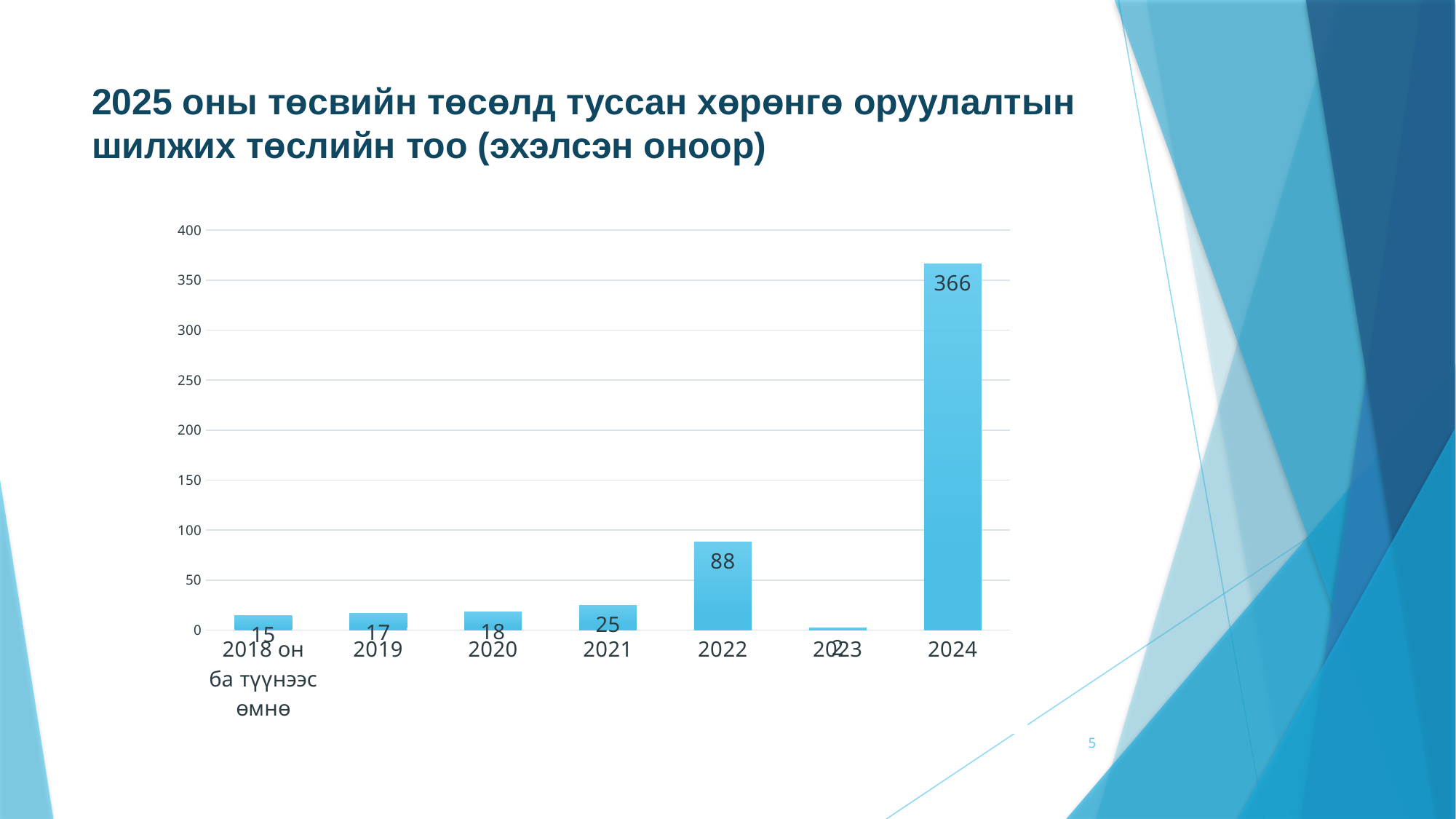
What is the value for 2024? 366 Which year has the lowest value? 2023 What is the value for 2022? 88 Which is larger, the value for 2021 or the value for 2020? 2021 What is the difference between the values for 2020 and 2019? 1 What is the value for 2021? 25 Which year has the highest value? 2024 What kind of chart is shown on the slide? bar chart How many categories are shown on the x axis? 7 What is the value for 2019? 17 Is the value for 2024 greater or less than 350? greater What is the difference between the values for 2024 and 2022? 278